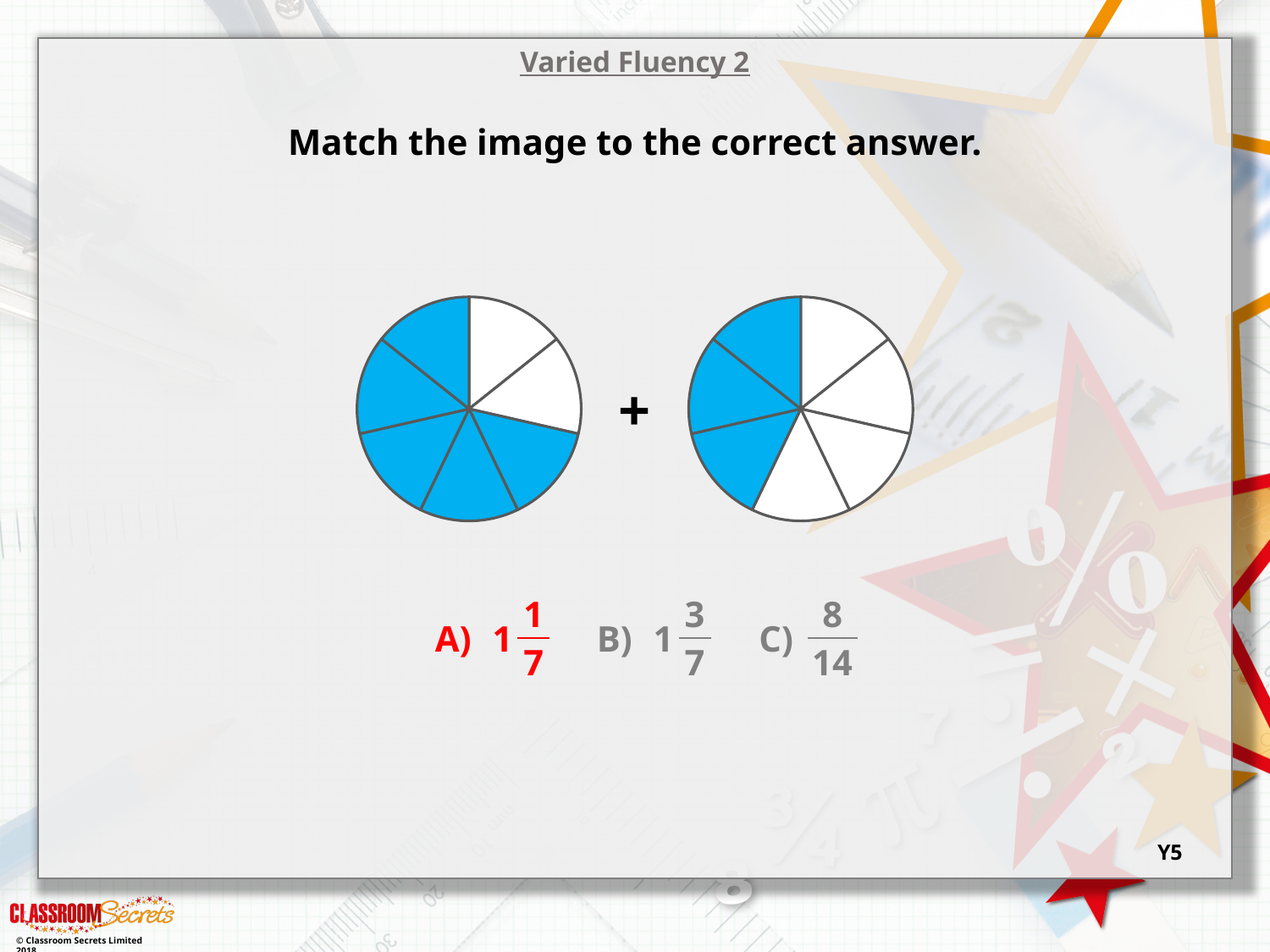
How many equal sectors is the right circle divided into? 7 Which circle has more blue-shaded sectors, the left or the right? left What kind of chart are the two circular diagrams on the slide? pie chart How many sectors of the right circle are left white? 4 How many equal sectors is the left circle divided into? 7 What is the underlined heading at the top of the slide? Varied Fluency 2 What colour are the shaded sectors in the two circles? blue How many more blue sectors does the left circle have than the right circle? 2 How many blue-shaded sectors are there in total across both circles? 8